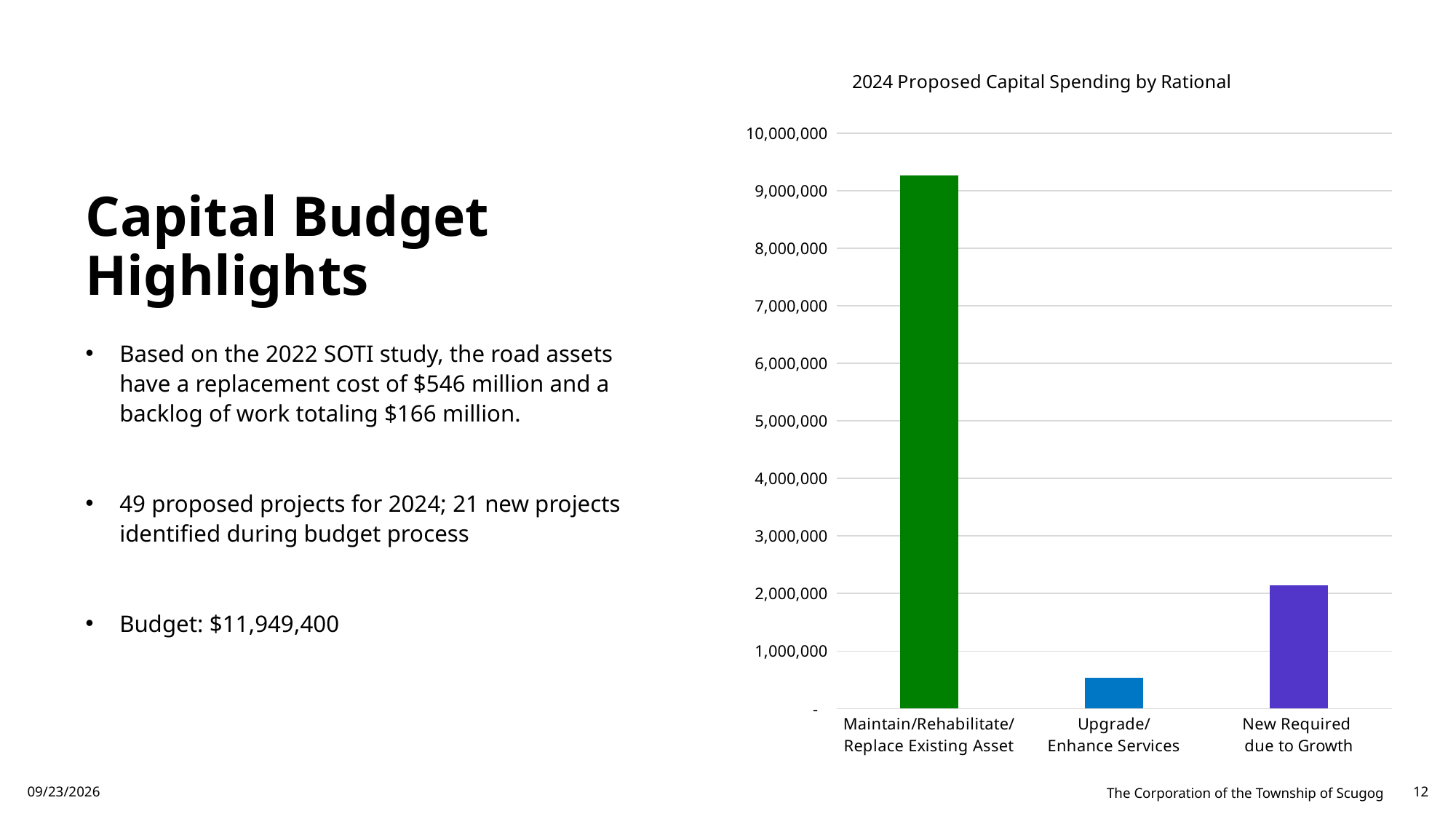
What is the title of the chart? 2024 Proposed Capital Spending by Rational Is the value for Maintain/Rehabilitate/Replace Existing Asset greater or less than 9,000,000? greater Is the value for New Required due to Growth greater or less than 1,000,000? greater Which category has the lowest proposed capital spending? Upgrade/Enhance Services What type of chart is shown on the slide? bar chart How many categories are shown on the x axis of the chart? 3 Which category has the highest proposed capital spending? Maintain/Rehabilitate/Replace Existing Asset What is the highest value shown on the y axis of the chart? 10,000,000 What colour is the bar for Maintain/Rehabilitate/Replace Existing Asset? green Is the value for New Required due to Growth greater or less than 3,000,000? less Which is larger, the value for New Required due to Growth or the value for Upgrade/Enhance Services? New Required due to Growth